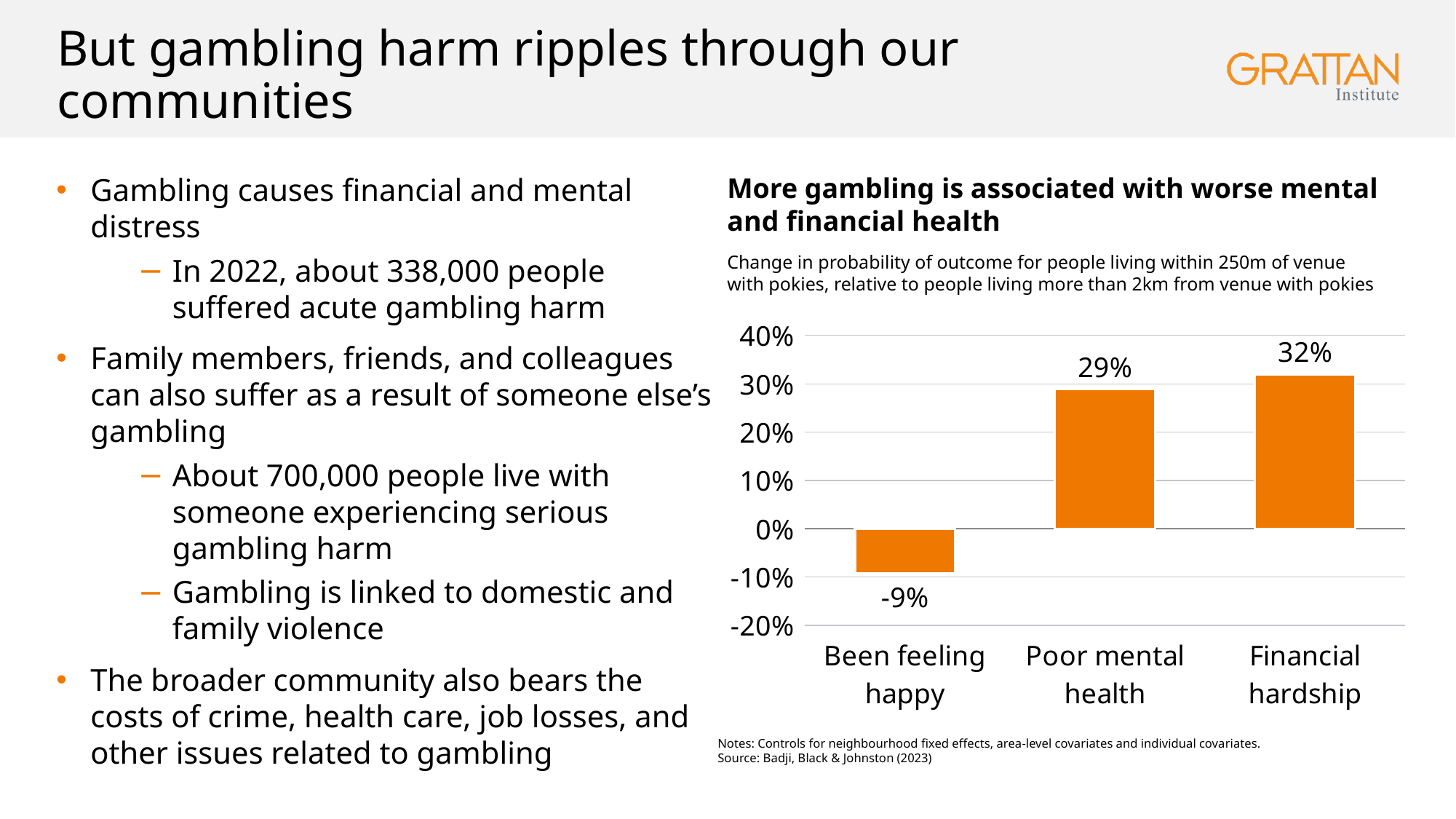
What is the value for Financial hardship? 32% How many categories are shown in the chart? 3 Is the value for Financial hardship greater or less than 30%? greater What is the title of the chart? More gambling is associated with worse mental and financial health Which category has the lowest value? Been feeling happy What kind of chart is shown on the slide? Bar chart What is the value for Been feeling happy? -9% What is the difference between the values for Financial hardship and Poor mental health? 3% What is the value for Poor mental health? 29% What is the difference between the values for Poor mental health and Been feeling happy? 38% Which category has the highest value? Financial hardship Which is larger, the value for Poor mental health or the value for Been feeling happy? Poor mental health